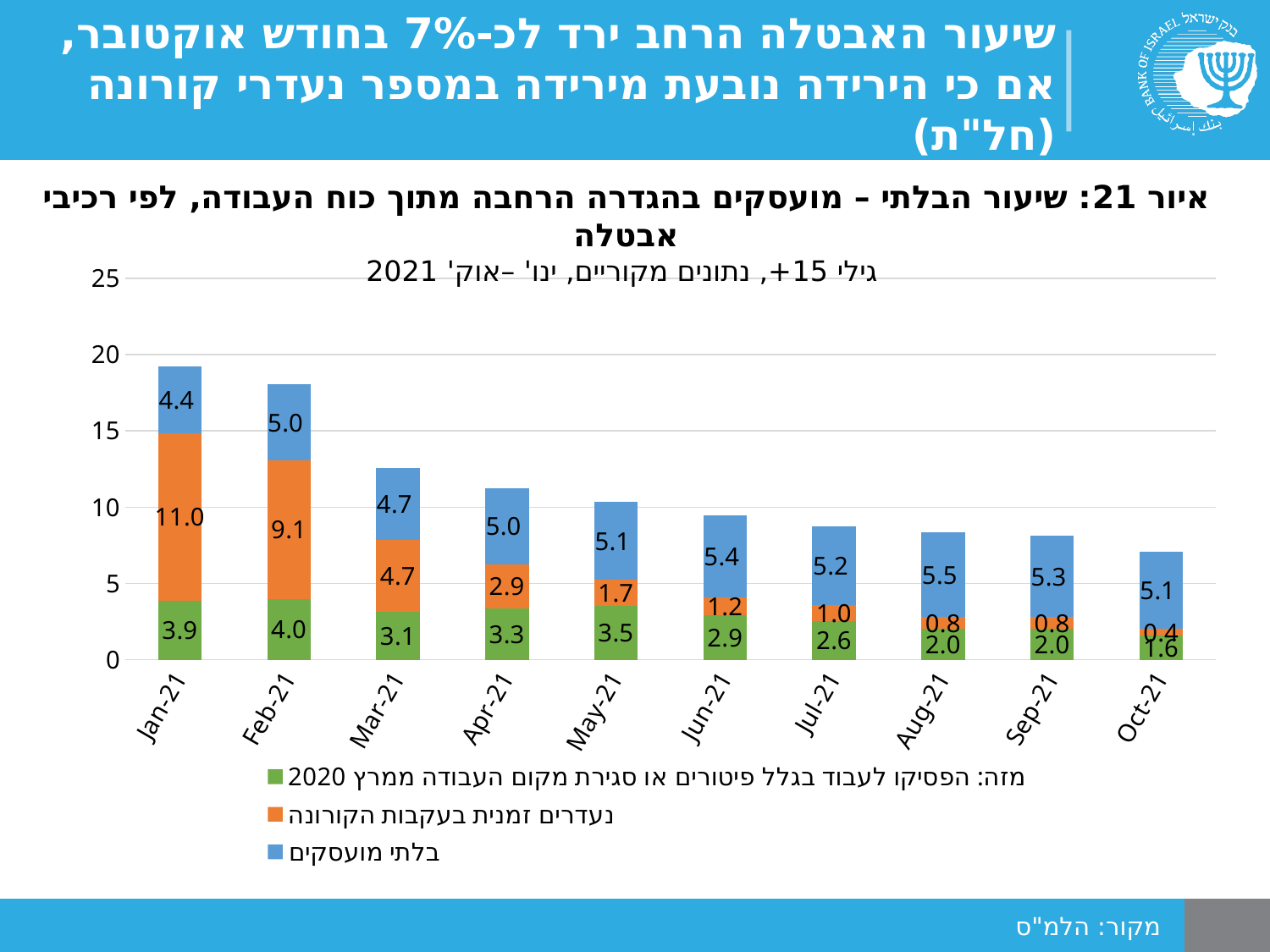
How many months (categories) are shown on the x axis? 10 In which month is the orange series (נעדרים זמנית בעקבות הקורונה) lowest? Oct-21 Which is larger for Mar-21: the green series value or the blue series value? the blue series (4.7) How many series does the legend list? 3 What is the difference between the orange series values for Jan-21 and Feb-21? 1.9 What is the total of the stacked bar for Oct-21? 7.1 What is the value of the green series for Oct-21? 1.6 What is the value of the blue series (בלתי מועסקים) for Aug-21? 5.5 Does the total height of the bars rise or fall from Jan-21 to Oct-21? fall What type of chart is shown on the slide? stacked bar chart In which month is the orange series (נעדרים זמנית בעקבות הקורונה) highest? Jan-21 What is the value of the orange series (נעדרים זמנית בעקבות הקורונה) for Jan-21? 11.0